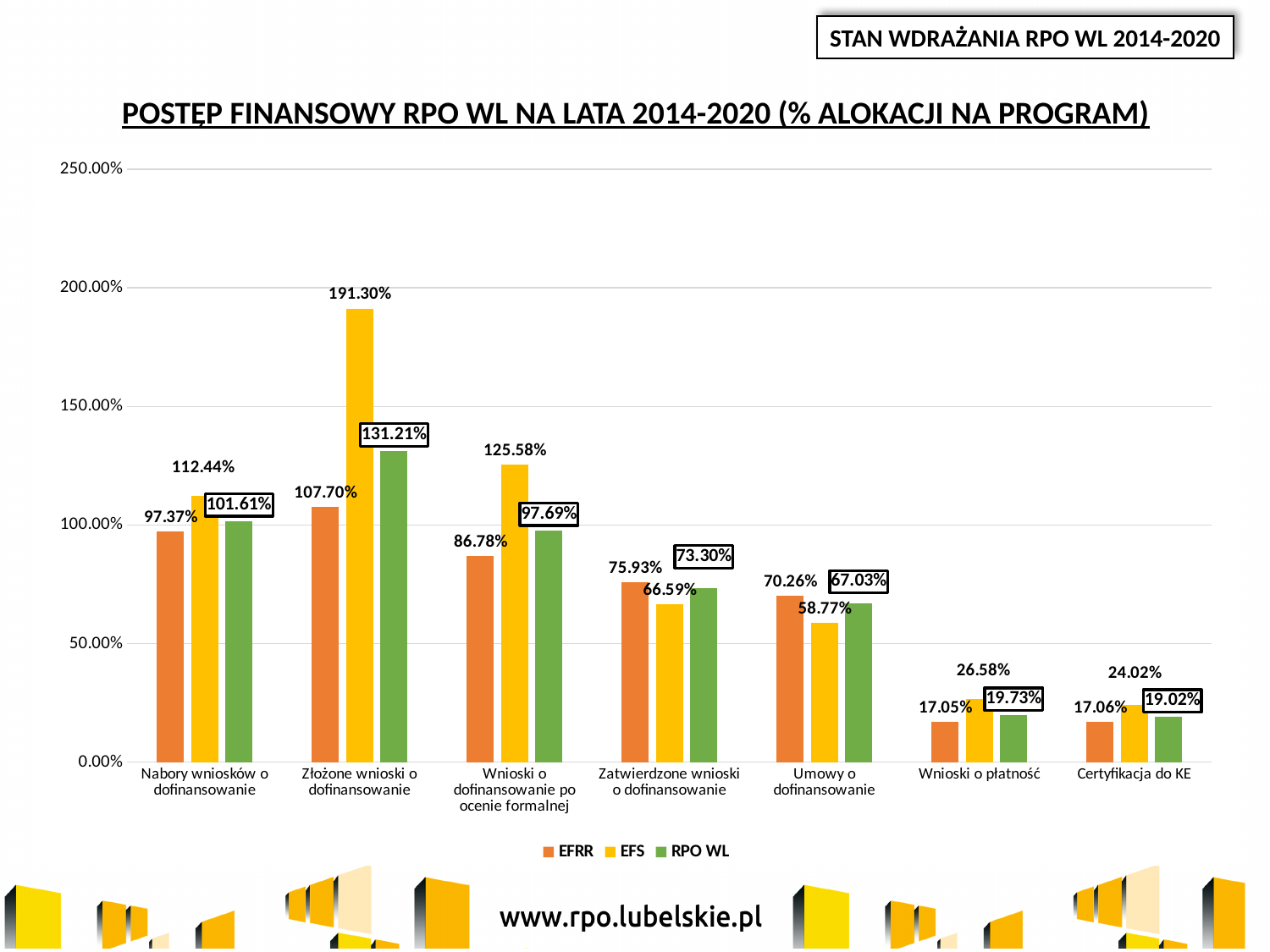
What type of chart is shown on the slide? bar chart What is the EFS value for Złożone wnioski o dofinansowanie? 191.30% Is the EFS value for Wnioski o płatność greater or less than 50.00%? less How many categories are shown on the x axis? 7 What is the EFRR value for Certyfikacja do KE? 17.06% Which series is shown in green in the legend? RPO WL For Zatwierdzone wnioski o dofinansowanie, which is larger: the EFRR value or the EFS value? EFRR Which category has the lowest EFRR value? Wnioski o płatność What is the difference between the EFS and EFRR values for Wnioski o dofinansowanie po ocenie formalnej? 38.80% What is the RPO WL value for Umowy o dofinansowanie? 67.03% How many series does the legend list? 3 Which category has the highest EFS value? Złożone wnioski o dofinansowanie